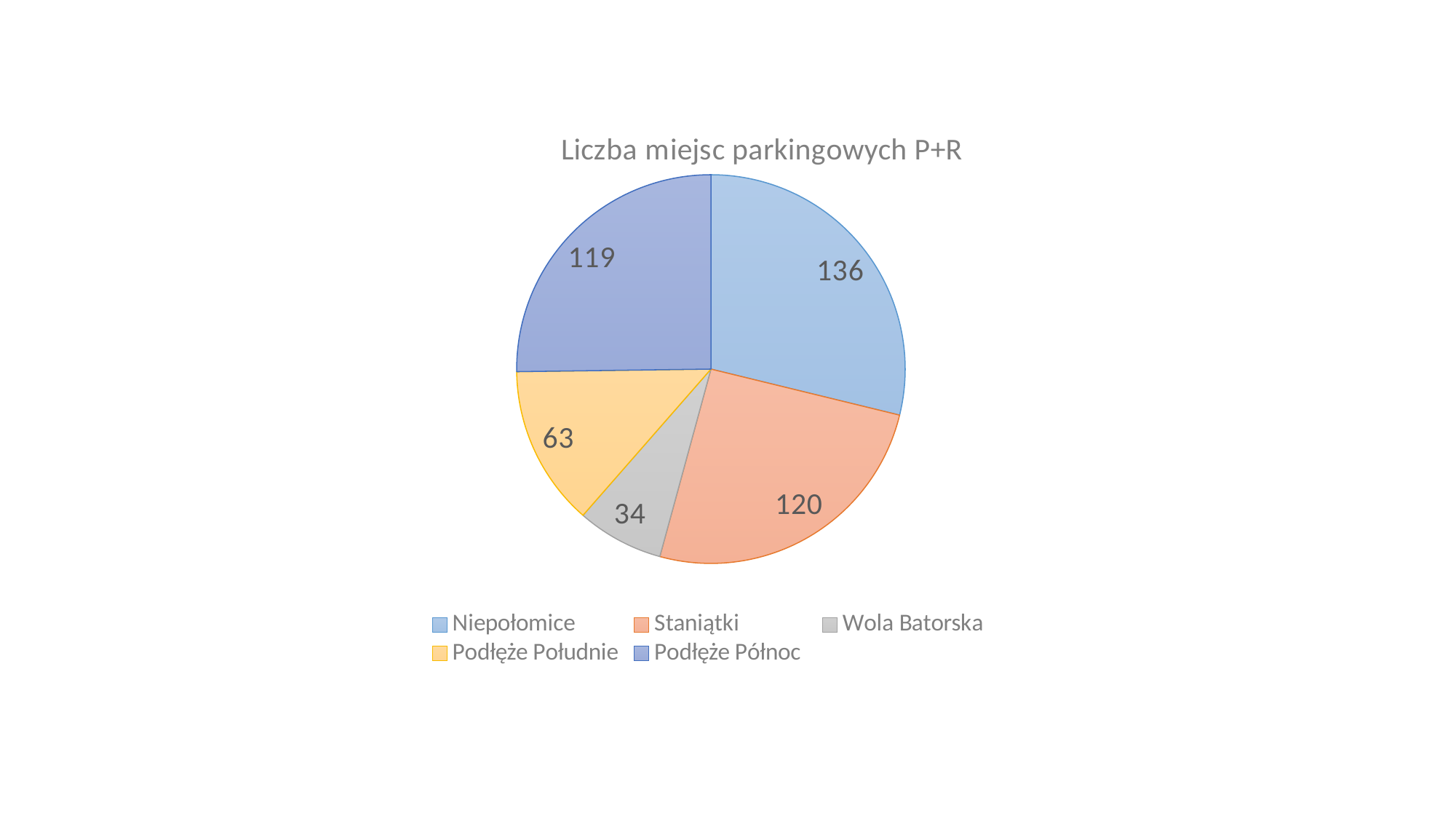
How many categories does the pie chart show? 5 What is the value for Podłęże Północ? 119 Which category has the largest slice? Niepołomice What is the value for Podłęże Południe? 63 What is the value for Staniątki? 120 What is the value for Wola Batorska? 34 Which category has the smallest slice? Wola Batorska What is the title of the chart? Liczba miejsc parkingowych P+R What is the value for Niepołomice? 136 What is the difference between the values for Niepołomice and Staniątki? 16 What kind of chart is shown on the slide? Pie chart Which is larger, the value for Podłęże Południe or the value for Podłęże Północ? Podłęże Północ